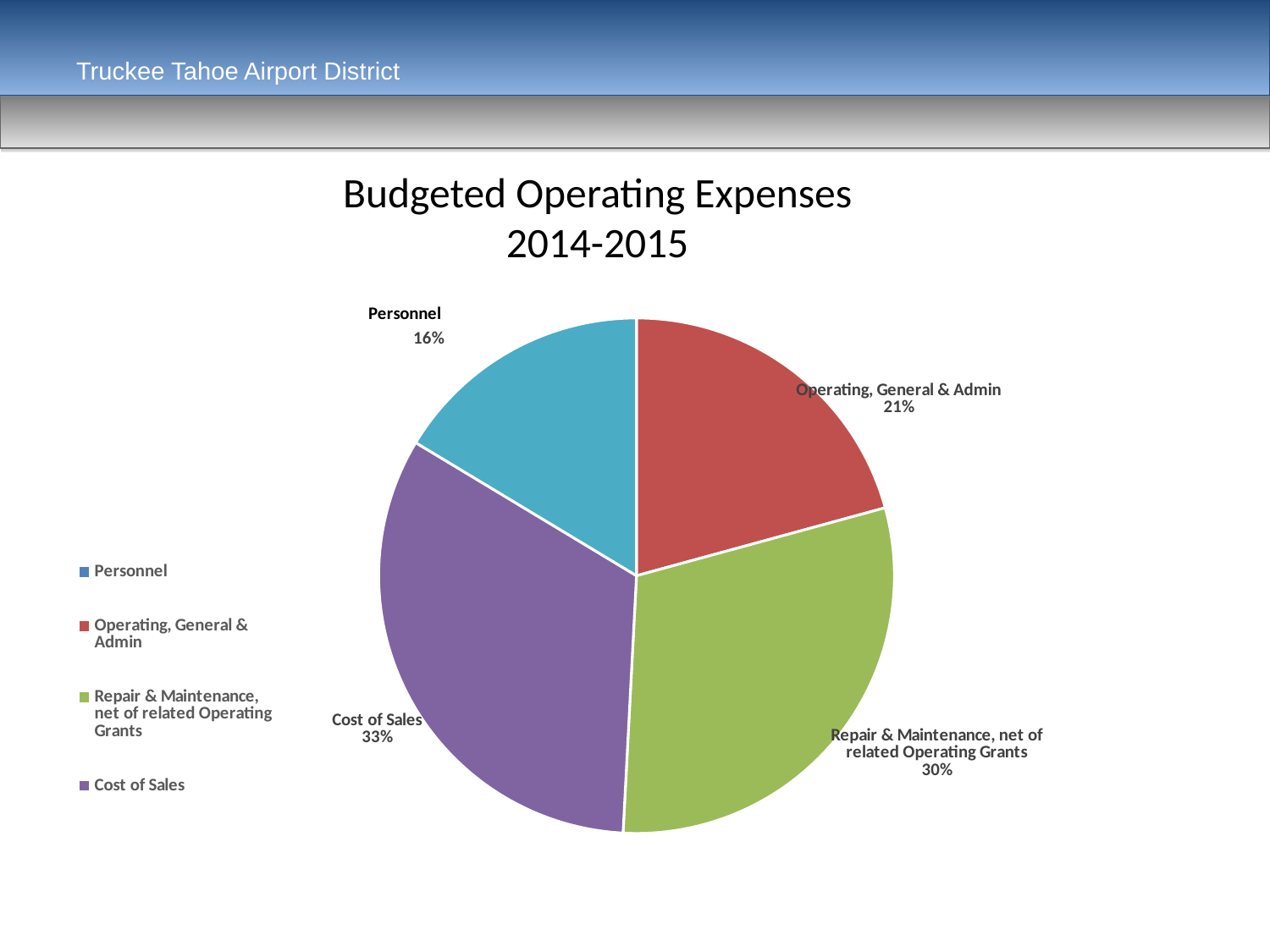
What share of budgeted operating expenses is Repair & Maintenance, net of related Operating Grants? 30% What is the difference in percentage points between Cost of Sales and Personnel? 17 What share of budgeted operating expenses is Personnel? 16% How many categories are shown in the pie chart? 4 What colour is the Cost of Sales slice? Purple Which category has the largest share of the pie? Cost of Sales Which is larger, Operating, General & Admin or Repair & Maintenance, net of related Operating Grants? Repair & Maintenance, net of related Operating Grants What share of budgeted operating expenses is Cost of Sales? 33% What type of chart is shown on the slide? Pie chart What is the title of the chart? Budgeted Operating Expenses 2014-2015 Which category has the smallest share of the pie? Personnel